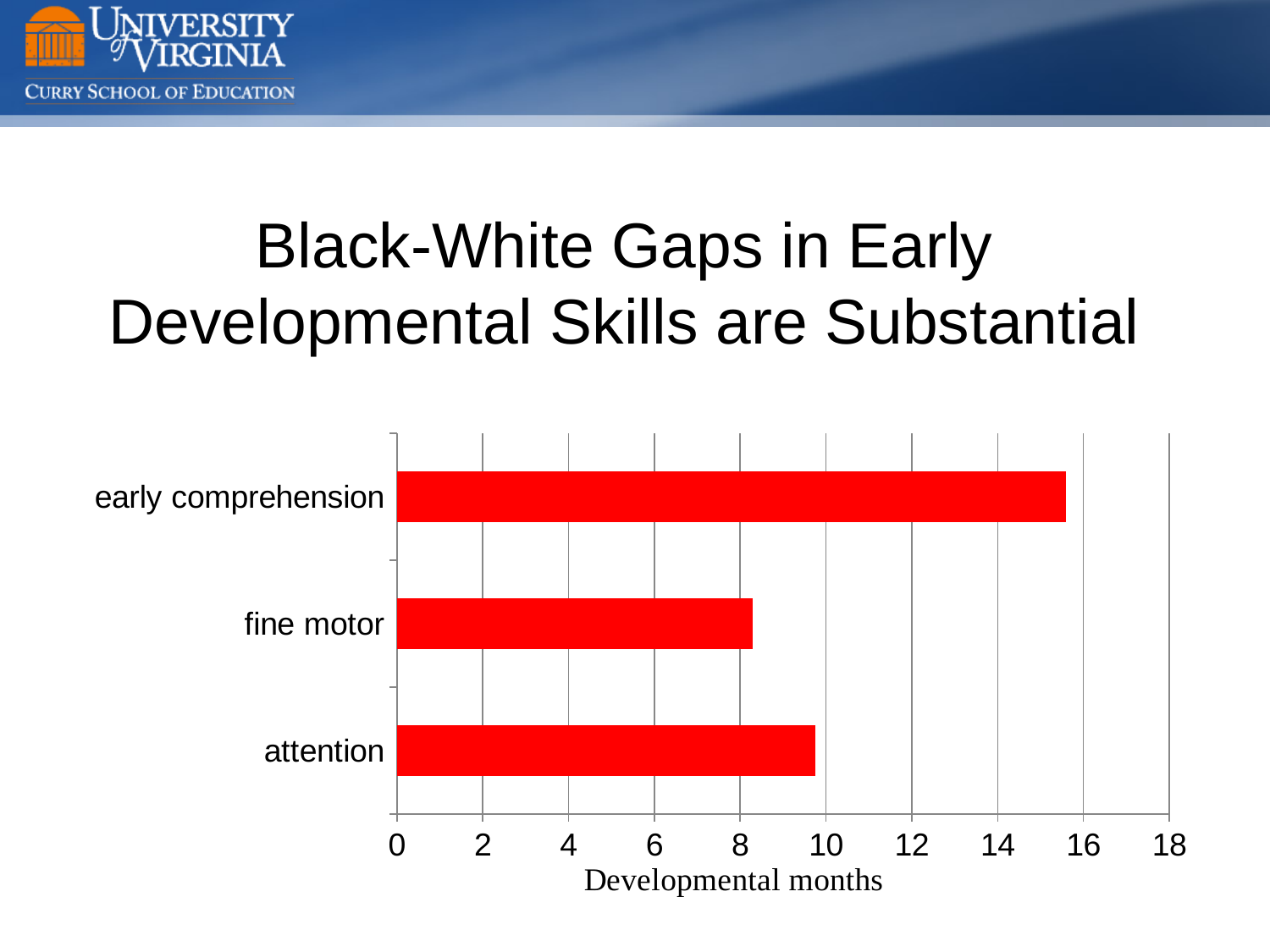
Is the value for early comprehension greater or less than 16? less Is the value for fine motor greater or less than 10? less How many categories are plotted in the chart? 3 Which is larger, the value for early comprehension or the value for attention? early comprehension What kind of chart is shown on the slide? bar chart What is the label of the horizontal axis? Developmental months Which category has the smallest gap in developmental months? fine motor Which category has the largest gap in developmental months? early comprehension What colour are the bars in the chart? red Is the value for early comprehension greater or less than 14? greater Which is larger, the value for attention or the value for fine motor? attention